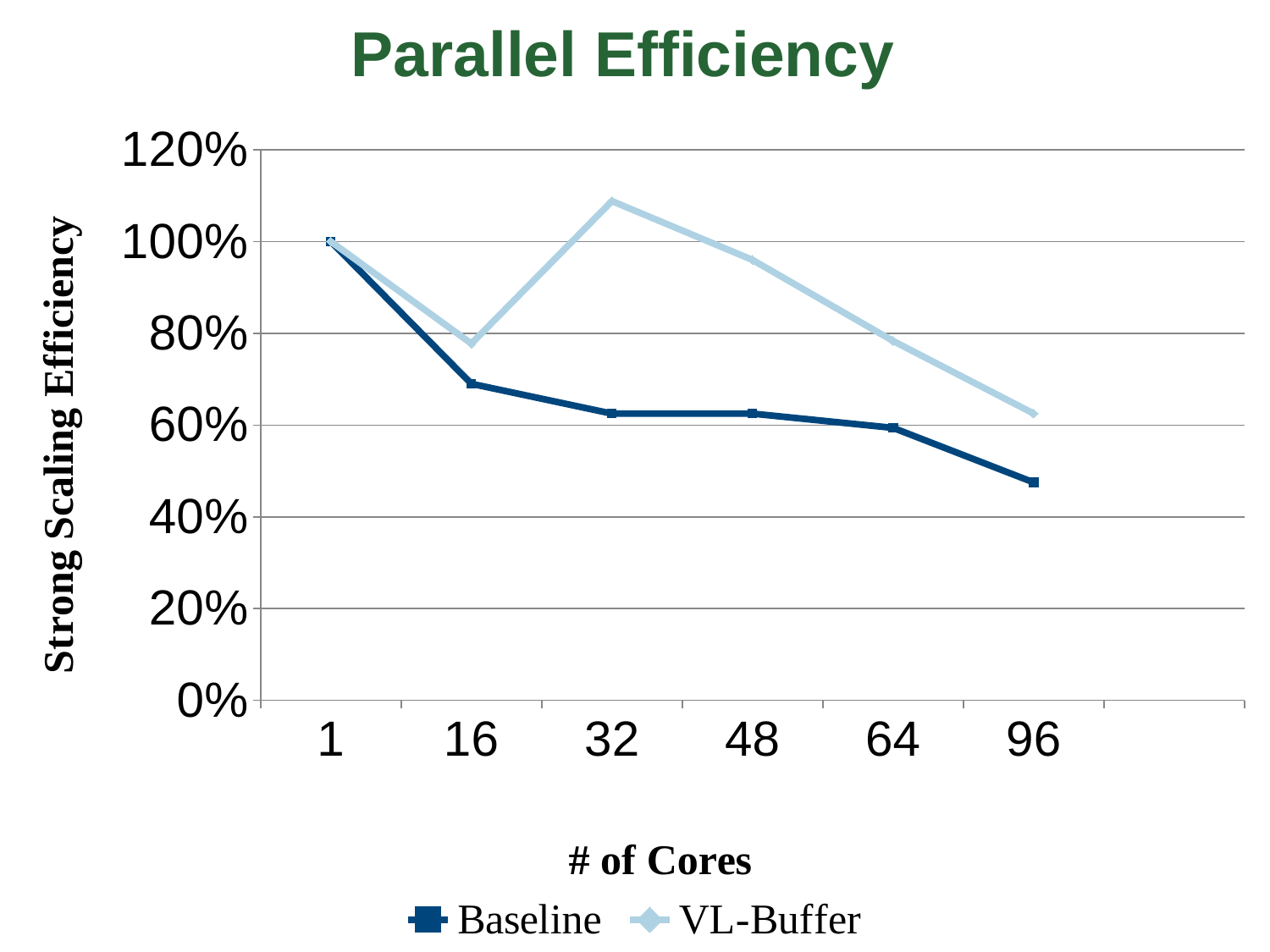
Is the Baseline value at 96 cores greater or less than 60%? less At which number of cores does the Baseline series reach its lowest value? 96 What is the Baseline strong scaling efficiency at 1 core? 100% What kind of chart is shown on the slide? line chart At 48 cores, which series has the higher strong scaling efficiency, Baseline or VL-Buffer? VL-Buffer At which number of cores does the VL-Buffer series reach its highest value? 32 Is the VL-Buffer value at 32 cores greater or less than 100%? greater How many series does the legend list? 2 What is the VL-Buffer strong scaling efficiency at 1 core? 100% Is the VL-Buffer value at 96 cores greater or less than 80%? less What is the label on the y axis? Strong Scaling Efficiency How many core counts are plotted along the x axis? 6